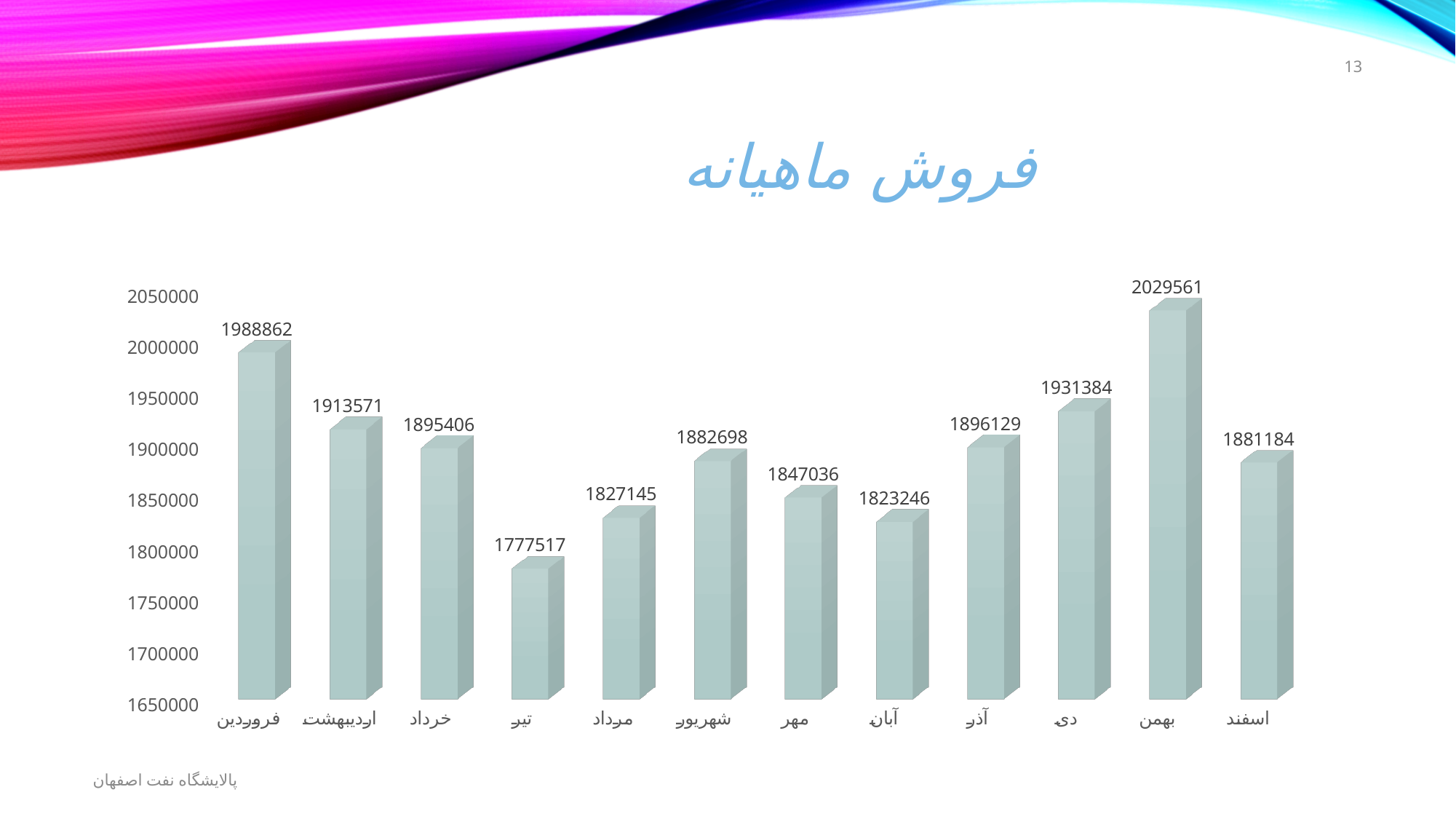
What kind of chart is shown on the slide? bar chart What is the difference between the values for بهمن and تیر? 252044 Which month has the lowest value? تیر How many months are shown on the chart? 12 Is the value for مهر greater or less than 1900000? less What is the value for فروردین? 1988862 What is the value for آبان? 1823246 What is the value for بهمن? 2029561 What is the difference between the values for دی and اسفند? 50200 Which month has the highest value? بهمن What is the value for تیر? 1777517 Which is larger, the value for اردیبهشت or the value for خرداد? اردیبهشت